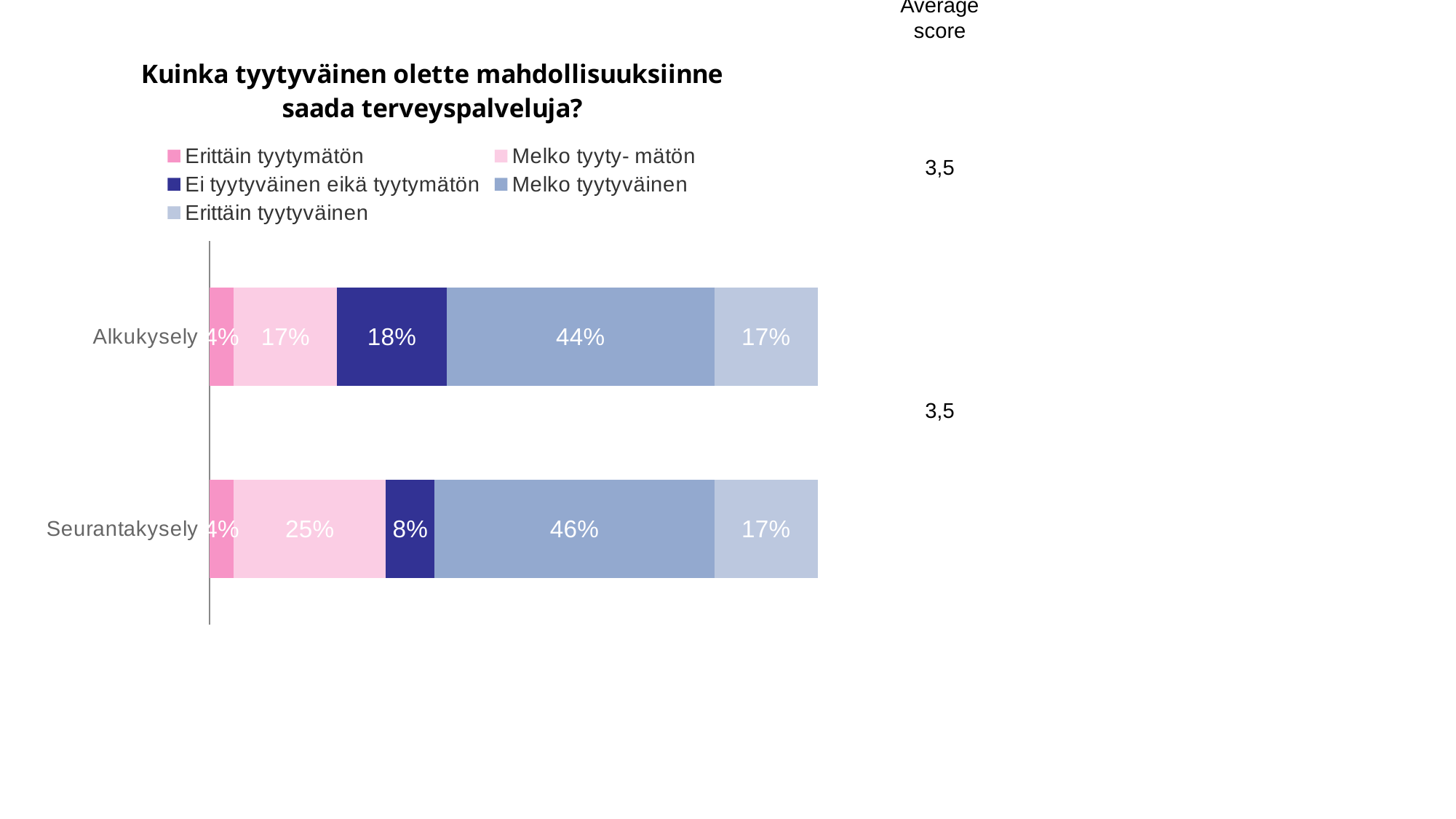
What is the average score shown for the Seurantakysely survey? 3,5 What is the value for "Erittäin tyytyväinen" in the Alkukysely bar? 17% What kind of chart is shown on the slide? Stacked bar chart Which response category has the smallest share in the Alkukysely bar? Erittäin tyytymätön Which response category has the largest share in the Seurantakysely bar? Melko tyytyväinen What percentage of Alkukysely respondents answered "Melko tyytyväinen"? 44% What is the difference between the "Ei tyytyväinen eikä tyytymätön" values for Alkukysely and Seurantakysely? 10% How many survey categories (bars) are shown in the chart? 2 What percentage of Seurantakysely respondents answered "Melko tyyty- mätön"? 25% What is the value for "Ei tyytyväinen eikä tyytymätön" in the Seurantakysely bar? 8% Which survey has the larger "Melko tyytyväinen" share, Alkukysely or Seurantakysely? Seurantakysely How many series does the legend list? 5